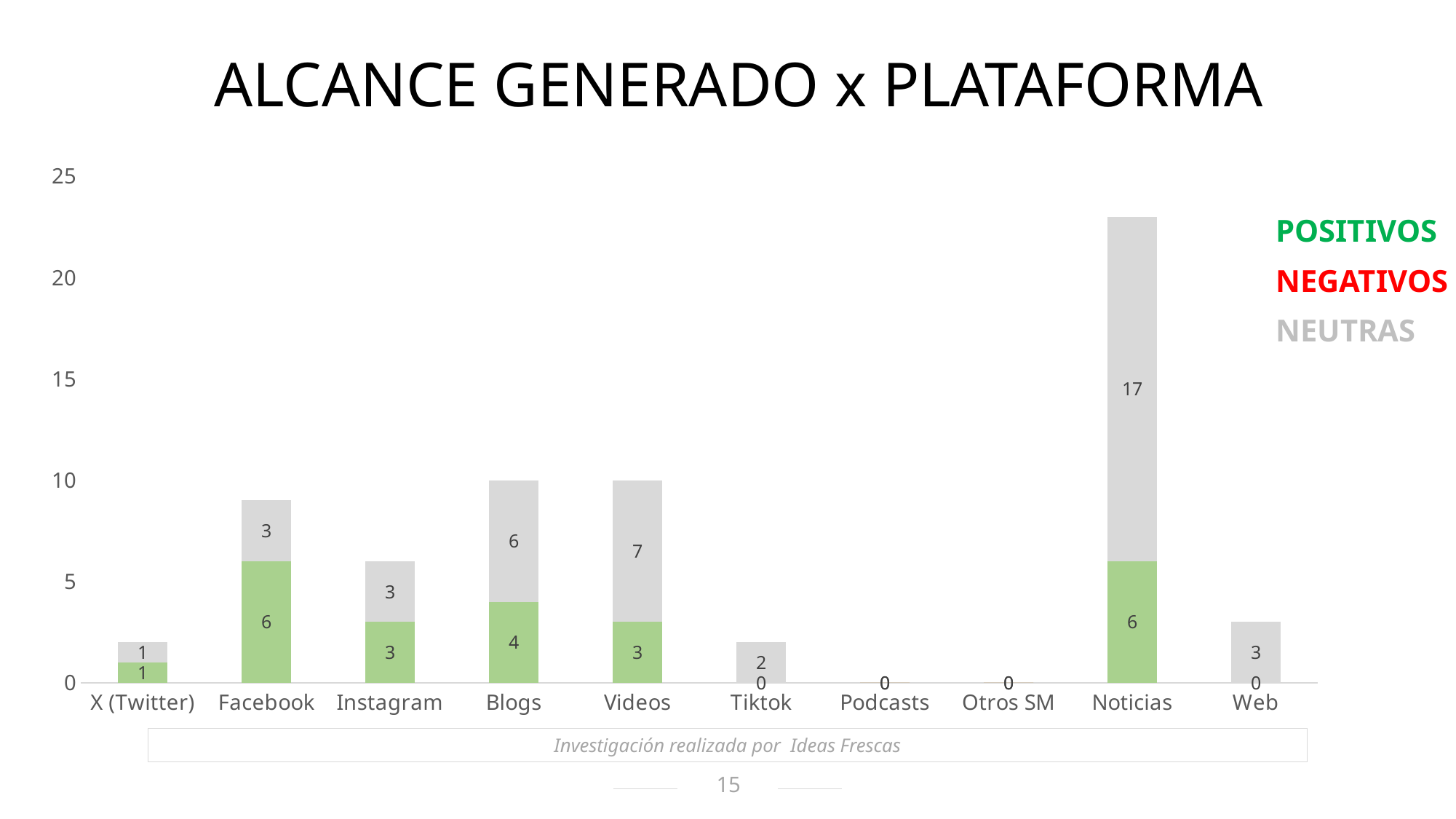
Which is larger, the POSITIVOS value for Blogs or the POSITIVOS value for Instagram? Blogs How many series does the legend list? 3 How many platform categories are shown on the x axis? 10 What is the difference between the NEUTRAS values for Noticias and Blogs? 11 What is the title of the chart? ALCANCE GENERADO x PLATAFORMA What kind of chart is shown on the slide? stacked bar chart What is the total of the stacked bar for Noticias? 23 What is the total of the stacked bar for Facebook? 9 Which platform has the tallest stacked bar overall? Noticias What is the NEUTRAS value for Videos? 7 What is the POSITIVOS value for Facebook? 6 What is the NEUTRAS value for Noticias? 17